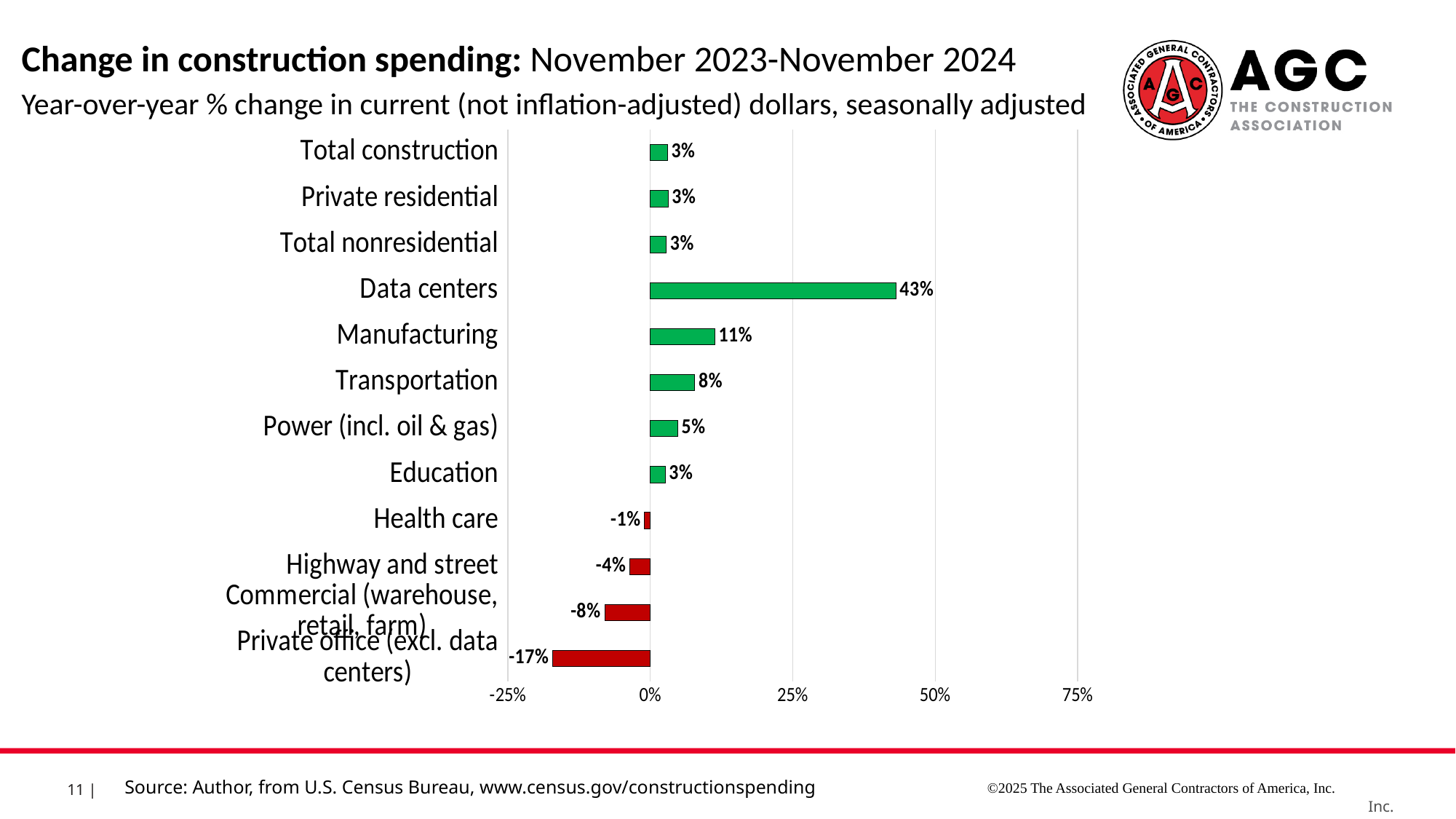
How many categories are shown in the chart? 12 What is the value for Manufacturing? 11% What kind of chart is shown on the slide? bar chart Is the value for Data centers greater or less than 25%? greater What is the value for Highway and street? -4% Which category has the lowest value? Private office (excl. data centers) What colour are the bars for categories with negative values? red Which is larger, the value for Transportation or the value for Power (incl. oil & gas)? Transportation What is the difference between the values for Data centers and Manufacturing? 32% What is the value for Private office (excl. data centers)? -17% Which category has the highest value? Data centers What is the value for Data centers? 43%